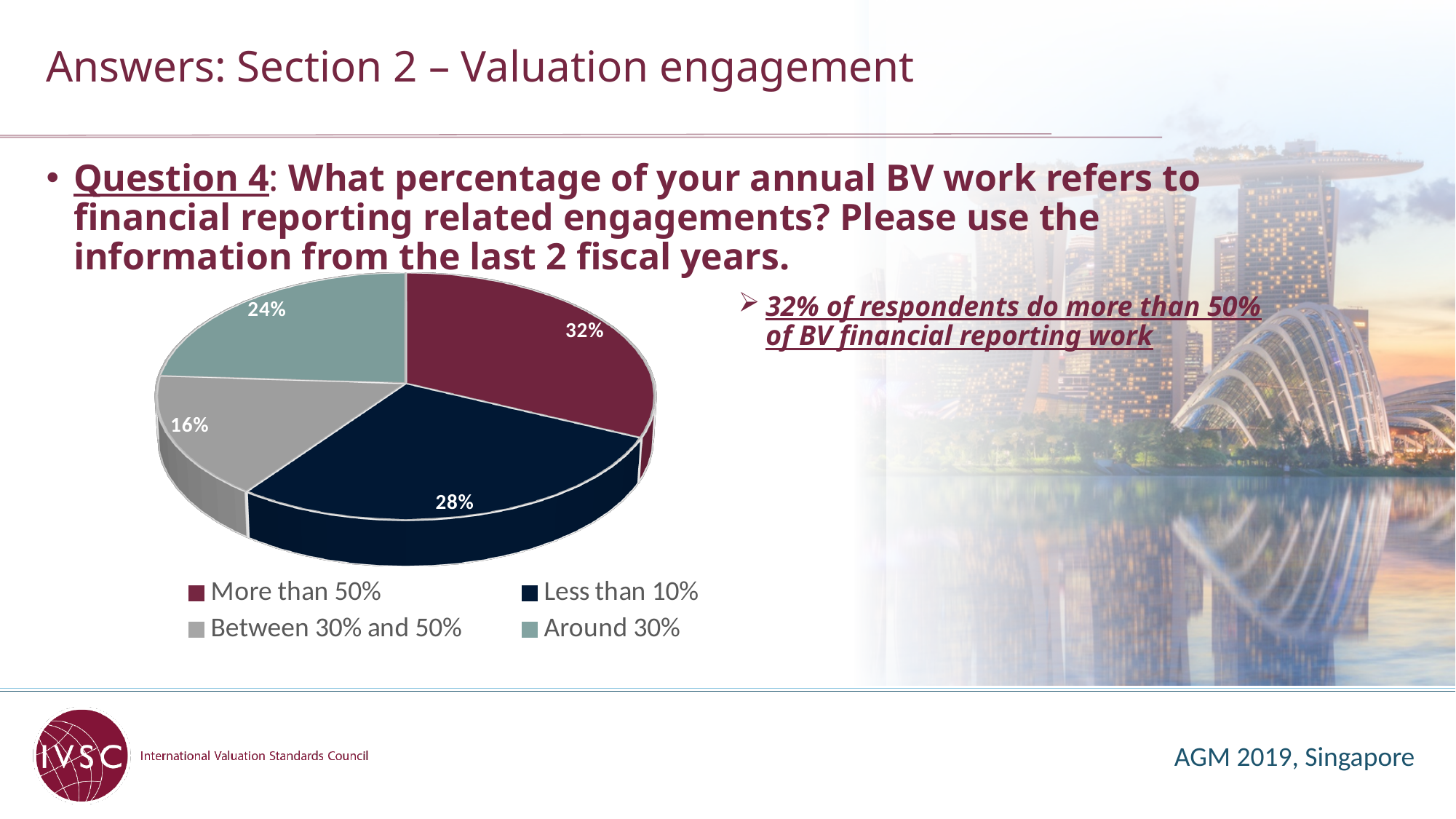
What share of the pie is labelled "Less than 10%"? 28% What colour is the "Less than 10%" slice in the pie chart? Dark navy blue How many entries does the legend of the pie chart list? 4 What kind of chart is shown on the slide? Pie chart Which slice is larger: "Less than 10%" or "Around 30%"? Less than 10% How many slices does the pie chart have? 4 What is the difference in percentage points between the "More than 50%" slice and the "Between 30% and 50%" slice? 16 What share of the pie is labelled "Between 30% and 50%"? 16% Which category has the largest slice of the pie? More than 50% What share of the pie is labelled "Around 30%"? 24% What share of the pie is labelled "More than 50%"? 32% Which category has the smallest slice of the pie? Between 30% and 50%